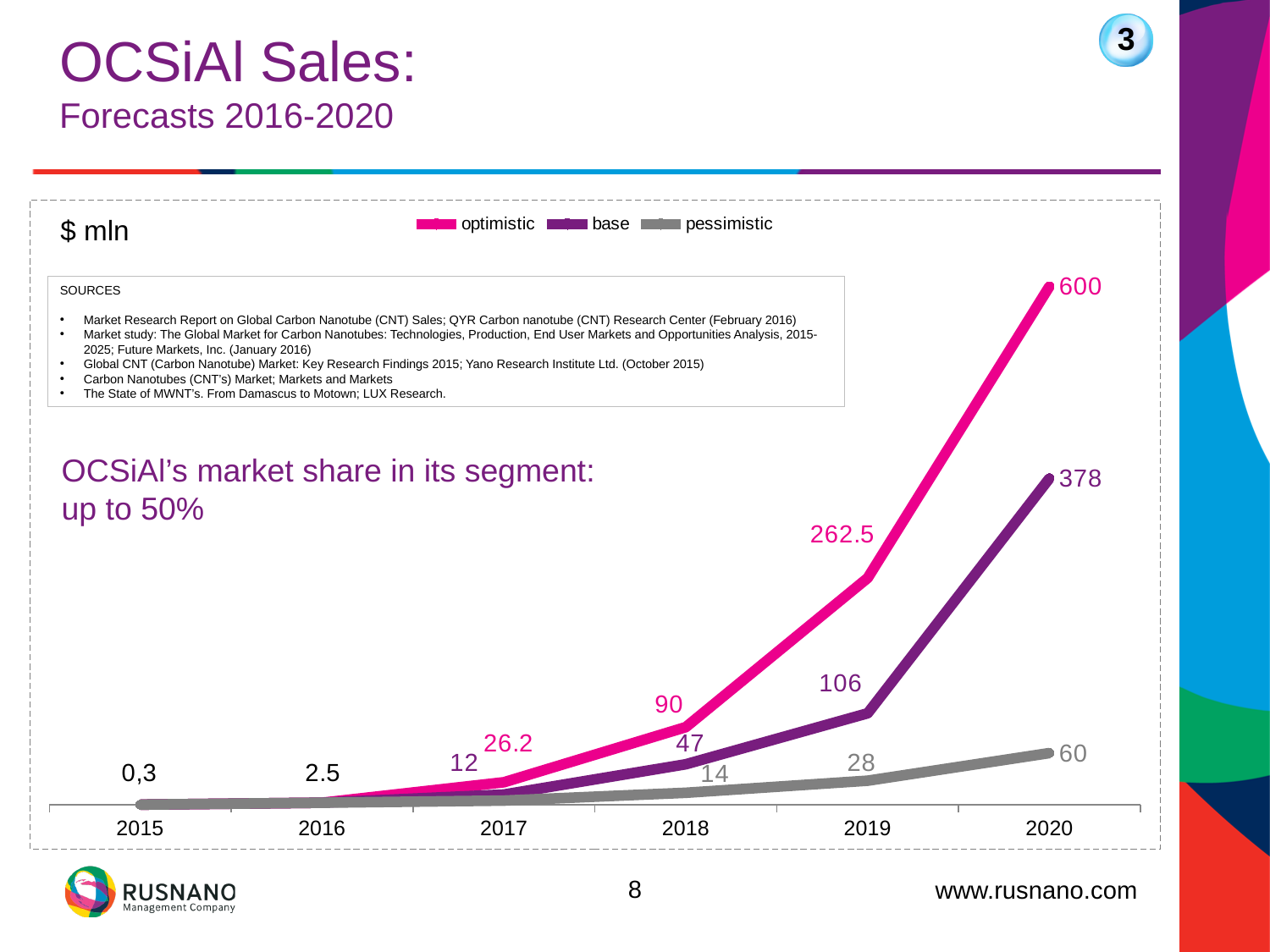
Do the optimistic forecast values rise or fall from 2015 to 2020? rise What is the optimistic forecast value for 2017? 26.2 What is the optimistic forecast value for 2020? 600 How many years are shown on the x axis? 6 How many series does the legend list? 3 Which series has the lowest value in 2019? pessimistic What is the base forecast value for 2019? 106 What kind of chart is shown on the slide? line chart Which series has the highest value in 2020? optimistic What is the pessimistic forecast value for 2018? 14 What is the difference between the optimistic and base forecasts for 2020? 222 Which is larger in 2018: the base forecast or the pessimistic forecast? base